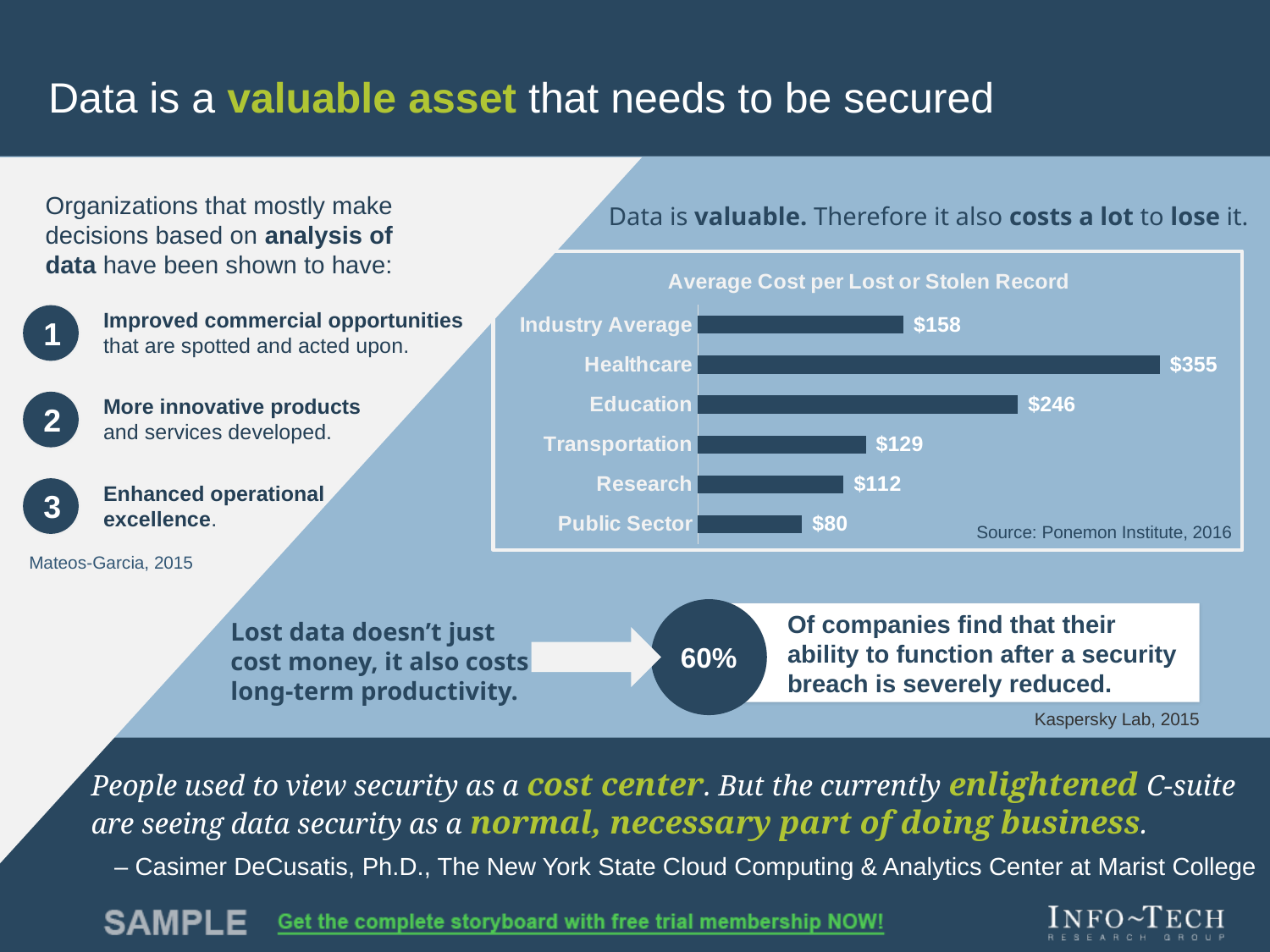
What is the average cost per lost or stolen record for Transportation? $129 What is the Industry Average cost per lost or stolen record? $158 Which category has the lowest average cost per lost or stolen record? Public Sector What is the difference between the average cost per record for Healthcare and Education? $109 How many categories are shown in the Average Cost per Lost or Stolen Record chart? 6 Which has a higher average cost per lost or stolen record, Education or Transportation? Education What is the difference between the average cost per record for Research and Public Sector? $32 Which category has the highest average cost per lost or stolen record? Healthcare What is the average cost per lost or stolen record for Healthcare? $355 Which has a higher average cost per lost or stolen record, Research or the Industry Average? Industry Average What is the title of the chart on the slide? Average Cost per Lost or Stolen Record What kind of chart is used to show the average cost per lost or stolen record? Bar chart